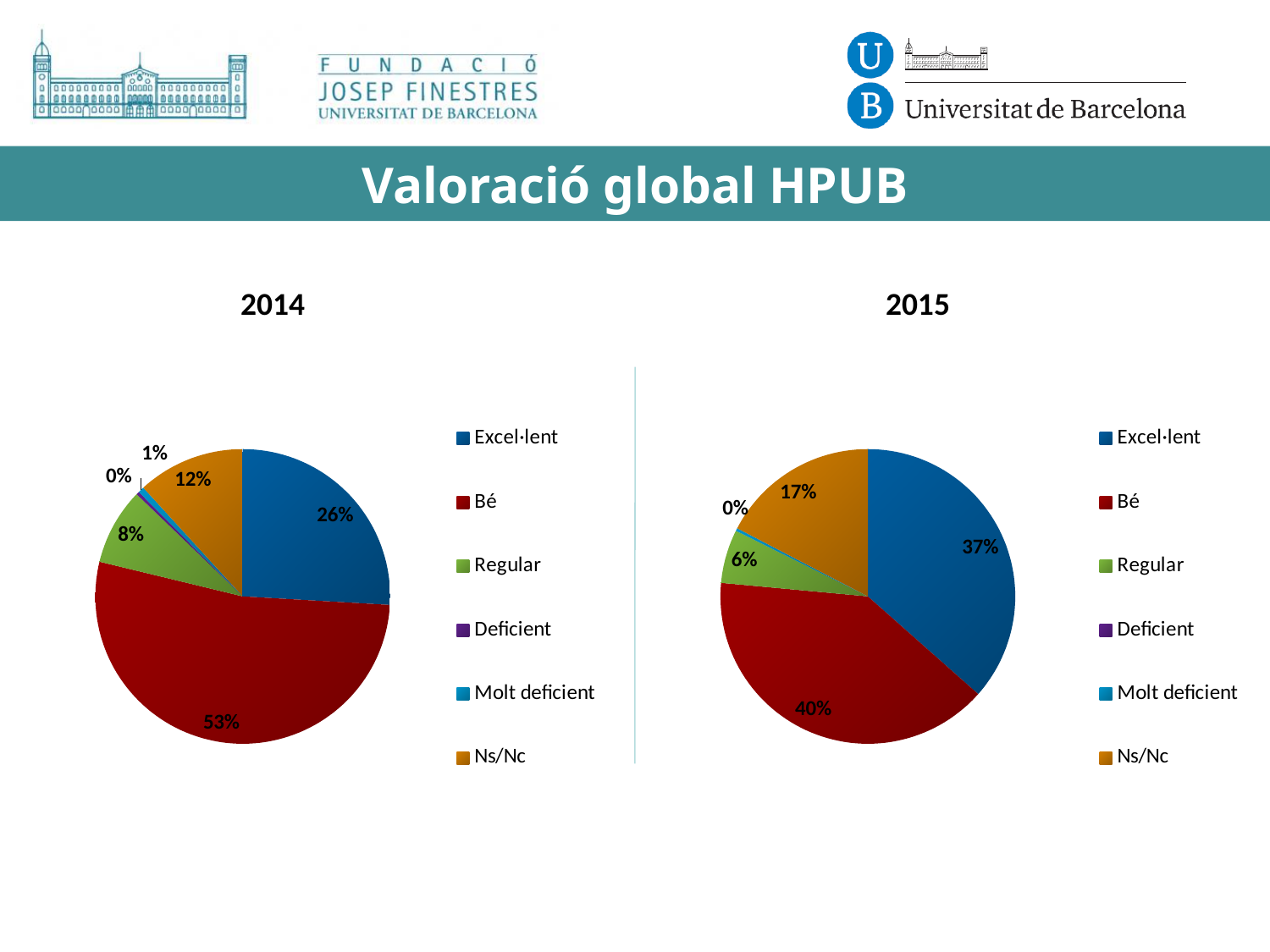
In the 2015 pie chart, what percentage is shown for Regular? 6% In the 2015 pie chart, what percentage is shown for Excel·lent? 37% In the 2014 pie chart, which category has the largest slice? Bé In the 2014 pie chart, what percentage is shown for Excel·lent? 26% In the 2015 pie chart, what is the difference between the Bé and Excel·lent percentages? 3% In the 2014 pie chart, what percentage is shown for Bé? 53% How many categories does the legend of the 2015 chart list? 6 In the 2015 pie chart, which category has the largest slice? Bé Is the Ns/Nc share larger in the 2014 chart or the 2015 chart? 2015 What type of chart is used for the 2014 data? Pie chart In the 2014 pie chart, what is the difference between the Bé and Excel·lent percentages? 27% In the 2014 pie chart, what percentage is shown for Ns/Nc? 12%